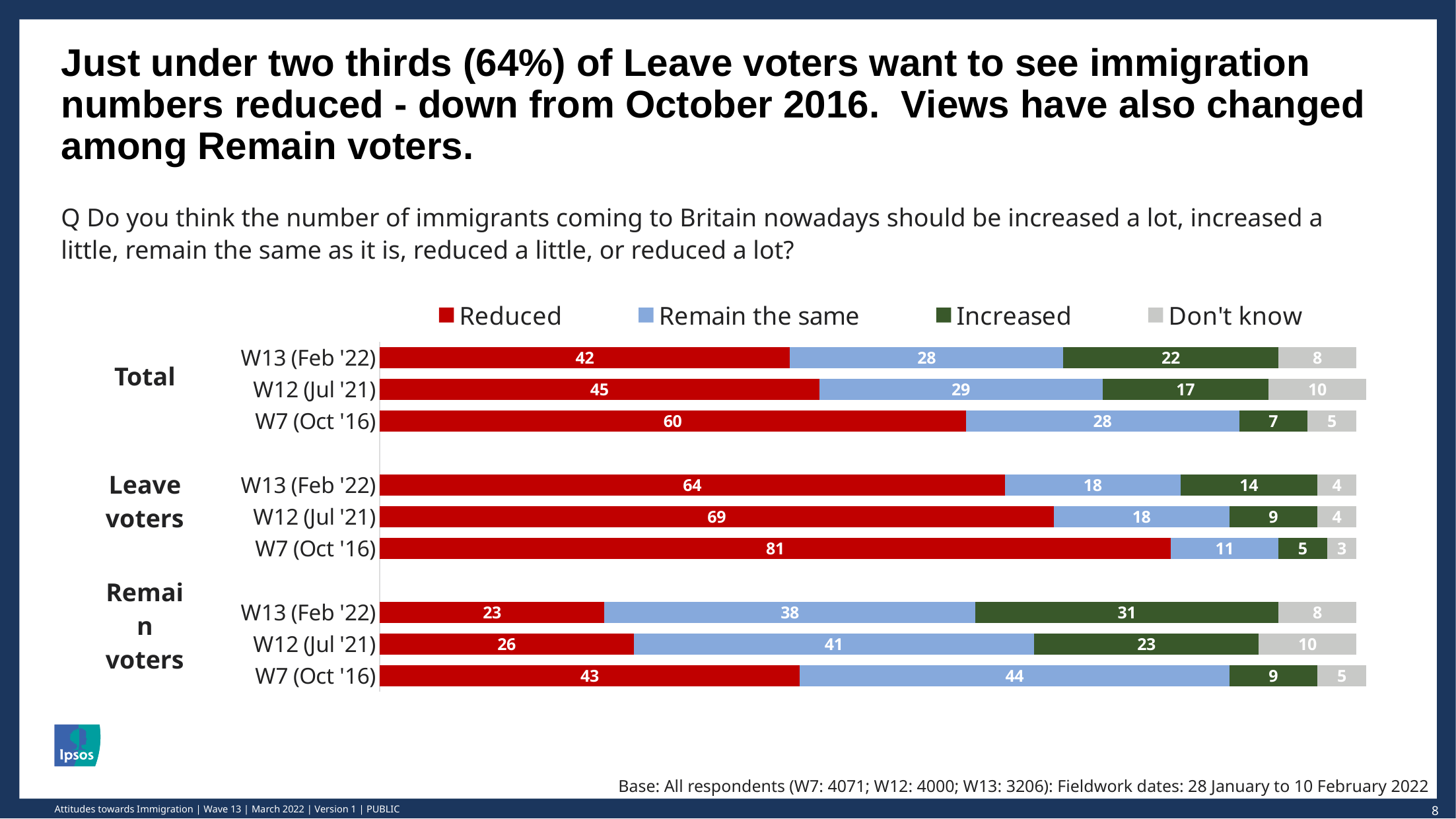
For Remain voters in W13 (Feb '22), which is larger: 'Remain the same' or 'Increased'? Remain the same What kind of chart is shown on the slide? Stacked bar chart Across all bars, which group and wave has the highest 'Reduced' value? Leave voters, W7 (Oct '16) What is the total of the stacked bar for Total in W12 (Jul '21)? 101 What is the 'Increased' value for Total in W7 (Oct '16)? 7 What percentage of Leave voters in W13 (Feb '22) said immigration should be Reduced? 64 What is the 'Don't know' value for Leave voters in W7 (Oct '16)? 3 How many series does the legend list? 4 What is the 'Remain the same' value for Remain voters in W12 (Jul '21)? 41 For Total, how does the 'Reduced' value change from W7 (Oct '16) to W13 (Feb '22)? It falls What is the difference between the 'Reduced' value for Leave voters in W7 (Oct '16) and in W13 (Feb '22)? 17 Across all bars, which group and wave has the lowest 'Reduced' value? Remain voters, W13 (Feb '22)